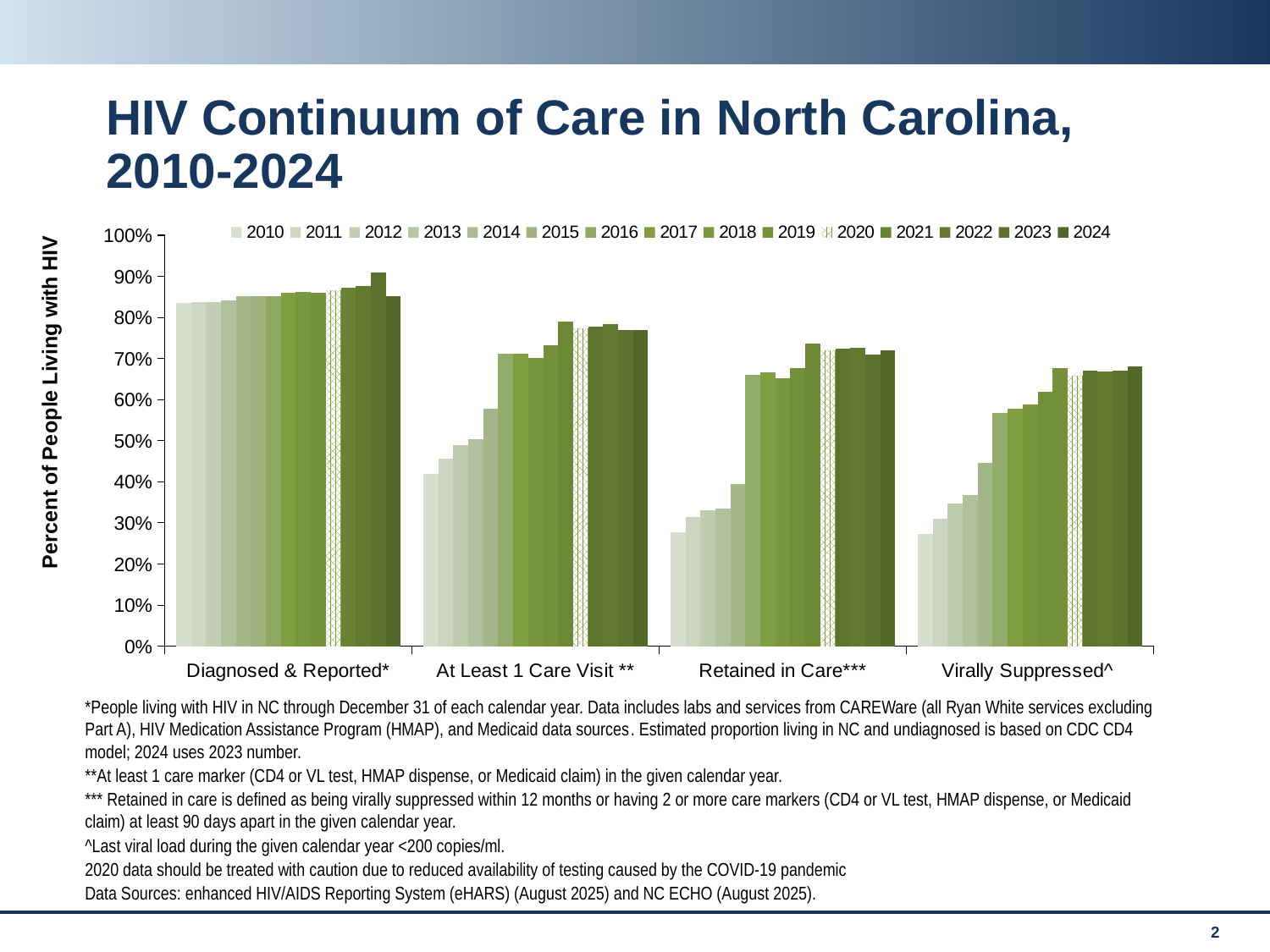
What is the label of the y axis? Percent of People Living with HIV How many categories are shown along the x axis of the chart? 4 Do the Virally Suppressed^ values generally rise or fall from 2010 to 2024? rise Is the 2024 value for At Least 1 Care Visit ** greater or less than 70%? greater Which category has the highest value for 2024? Diagnosed & Reported* Which year in the legend is shown with a hatched pattern instead of a solid fill? 2020 Is the 2010 value for Retained in Care*** greater or less than 30%? less Is the 2024 value for Virally Suppressed^ greater or less than 60%? greater What kind of chart is shown on the slide? bar chart How many series (years) does the legend list? 15